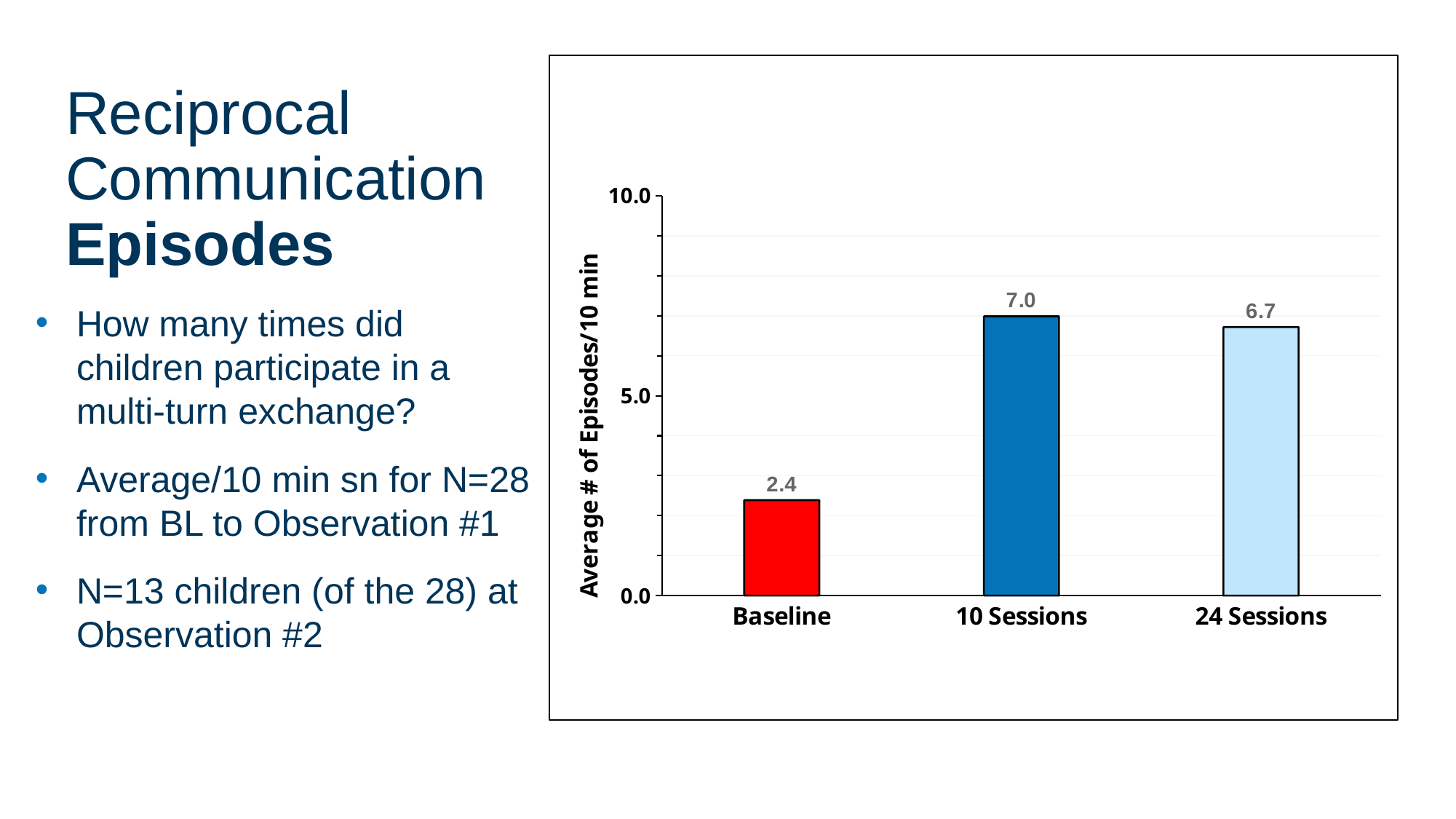
Is the value for Baseline greater or less than 5.0? less What is the average number of episodes per 10 min at 24 Sessions? 6.7 What is the average number of episodes per 10 min at Baseline? 2.4 Which is larger, the value for Baseline or the value for 24 Sessions? 24 Sessions Which category has the highest average number of episodes per 10 min? 10 Sessions What is the difference between the values for 10 Sessions and Baseline? 4.6 What is the difference between the values for 24 Sessions and Baseline? 4.3 What kind of chart is shown on the slide? bar chart How many categories are shown on the x axis of the chart? 3 What is the label of the y axis of the chart? Average # of Episodes/10 min Which category has the lowest average number of episodes per 10 min? Baseline What is the average number of episodes per 10 min at 10 Sessions? 7.0